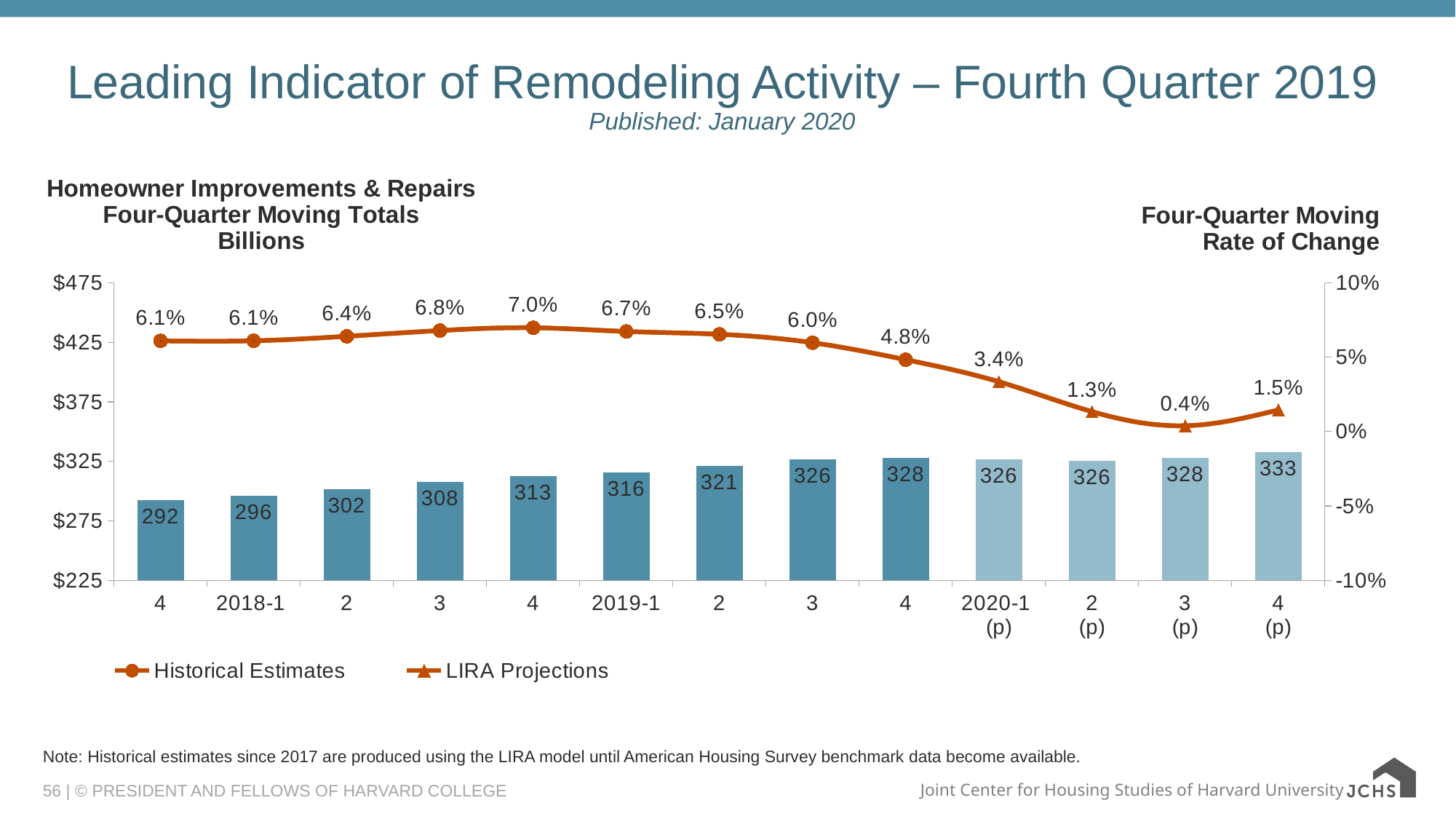
Which quarter has the lowest four-quarter moving rate of change? 2020-3 (p) (0.4%) What is the difference between the four-quarter moving total for 2020-4 (p) and for 2019 Q4? 5 Which quarter has the highest four-quarter moving rate of change? 2018 Q4 (7.0%) Which is larger, the four-quarter moving total for 2019-2 or for 2018-2? 2019-2 What four-quarter moving rate of change is labeled for the fourth quarter of 2018 (the bar labeled 4 after 2018-3)? 7.0% Does the four-quarter moving rate of change rise or fall from 2018 Q4 to 2020-3 (p)? Fall How many quarters (bars) are plotted on the chart? 13 What rate of change is projected for 2020-1 (p)? 3.4% Which quarter has the highest four-quarter moving total in billions? 2020-4 (p) (333) How many series does the legend list? 2 What is the four-quarter moving total (in billions) shown for 2019-1? 316 What kind of chart is this? Combination bar and line chart